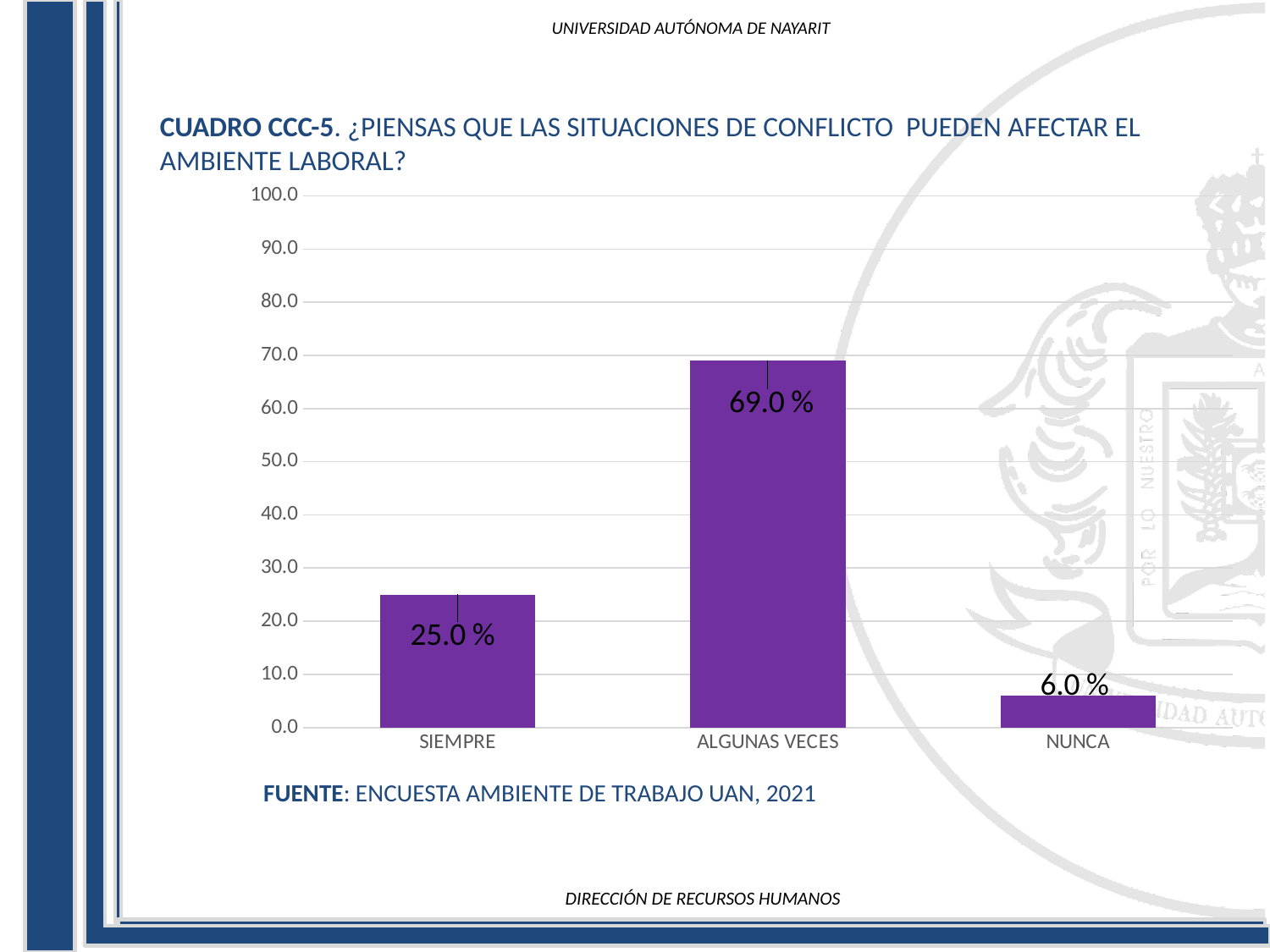
Which category has the highest value? ALGUNAS VECES What is the source cited below the chart? ENCUESTA AMBIENTE DE TRABAJO UAN, 2021 What kind of chart is shown on the slide? bar chart How many categories are shown on the x axis? 3 What is the value for SIEMPRE? 25.0 % What is the value for ALGUNAS VECES? 69.0 % What is the difference between the values for ALGUNAS VECES and SIEMPRE? 44.0 % Which is larger, the value for SIEMPRE or the value for NUNCA? SIEMPRE What is the value for NUNCA? 6.0 % What is the difference between the values for SIEMPRE and NUNCA? 19.0 % Is the value for ALGUNAS VECES greater or less than 60.0? greater Which category has the lowest value? NUNCA